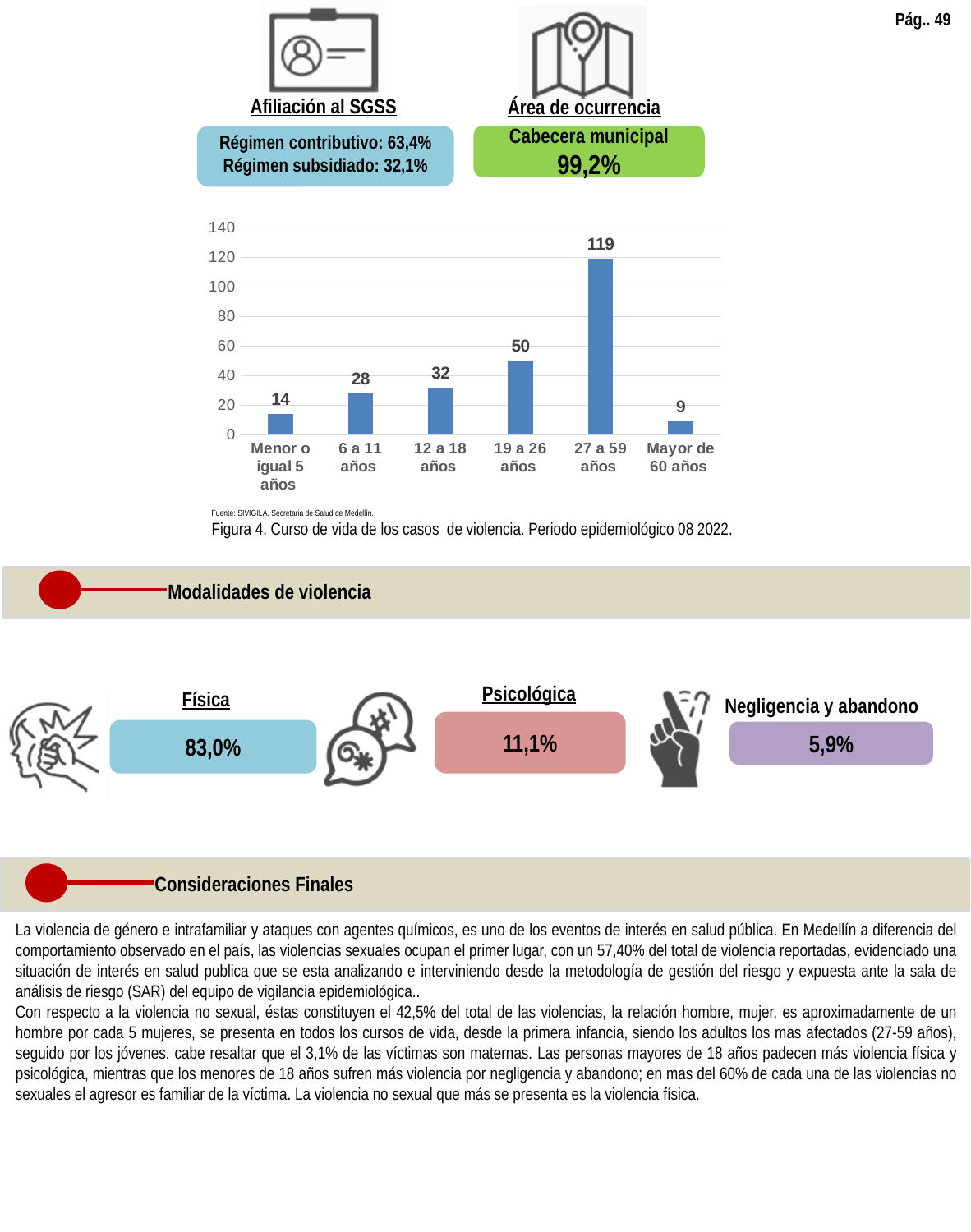
Is the value for '27 a 59 años' in the bar chart greater or less than 100? greater Which age group has the highest value in the bar chart? 27 a 59 años What is the caption of the bar chart (Figura 4)? Curso de vida de los casos de violencia. Periodo epidemiológico 08 2022. What is the difference between the values for '12 a 18 años' and '6 a 11 años' in the bar chart? 4 What is the value for the '19 a 26 años' category in the bar chart? 50 Which is larger in the bar chart, the value for '6 a 11 años' or the value for 'Mayor de 60 años'? 6 a 11 años How many age categories are shown in the bar chart? 6 What type of chart is used to show the cases of violence by age group? Bar chart What is the value for the 'Menor o igual 5 años' category in the bar chart? 14 What is the value for the '27 a 59 años' category in the bar chart? 119 Which age group has the lowest value in the bar chart? Mayor de 60 años What is the difference between the values for '27 a 59 años' and '19 a 26 años' in the bar chart? 69